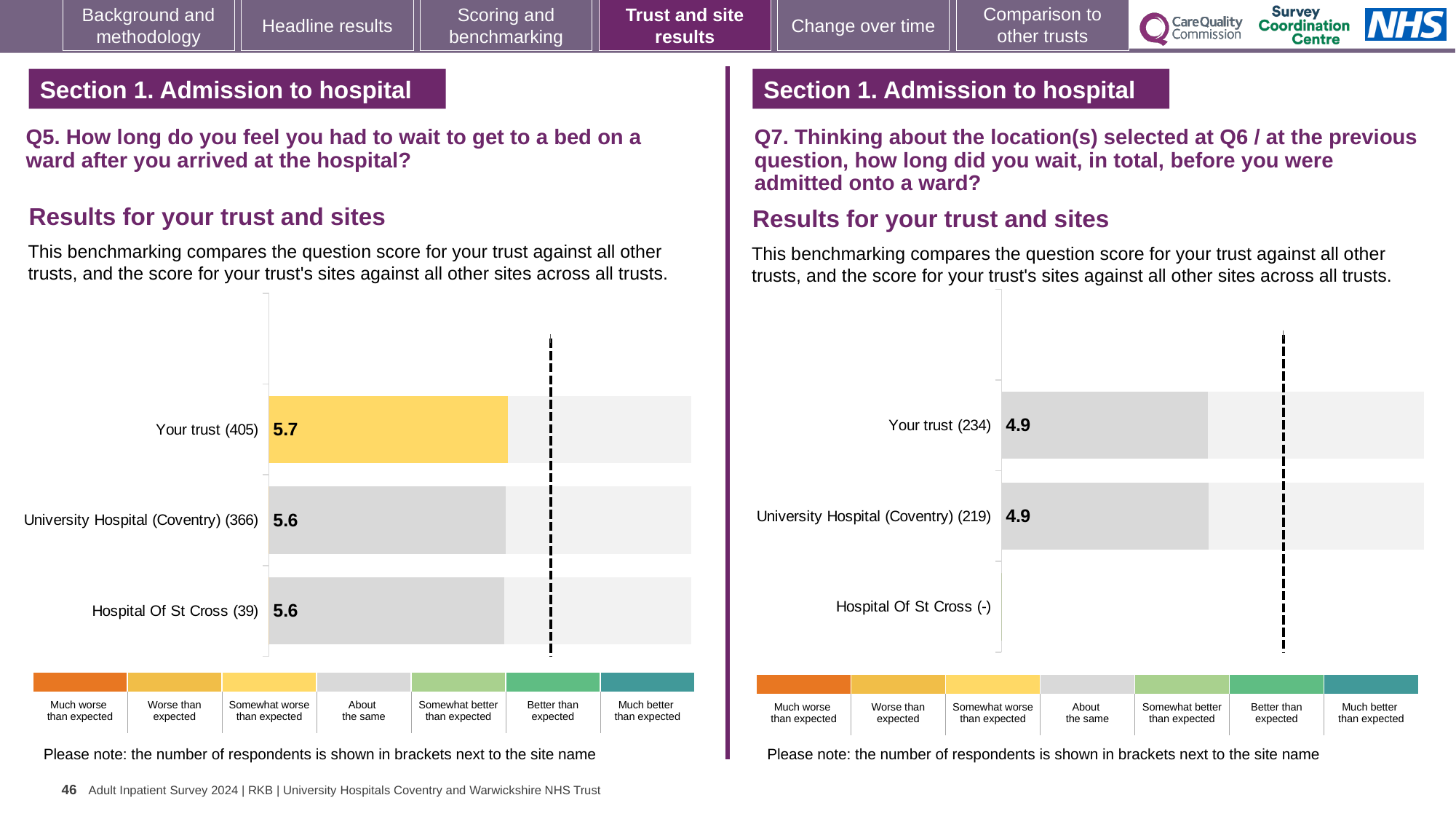
On the left chart (Q5), what is the score for Your trust? 5.7 On the right chart (Q7), what is the score for University Hospital (Coventry)? 4.9 On the right chart (Q7), how many categories have a score shown? 2 On the left chart (Q5), what is the score for Hospital Of St Cross? 5.6 On the right chart (Q7), what is the score for Your trust? 4.9 What kind of chart is shown on the left (Q5)? Bar chart On the left chart (Q5), how many respondents are shown in brackets for Your trust? 405 On the left chart (Q5), what is the difference between the score for Your trust and the score for University Hospital (Coventry)? 0.1 On the left chart (Q5), which benchmark category does the colour of the Your trust bar correspond to in the legend? Somewhat worse than expected On the left chart (Q5), which category has the highest score? Your trust On the left chart (Q5), how many categories are plotted? 3 On the left chart (Q5), what is the score for University Hospital (Coventry)? 5.6